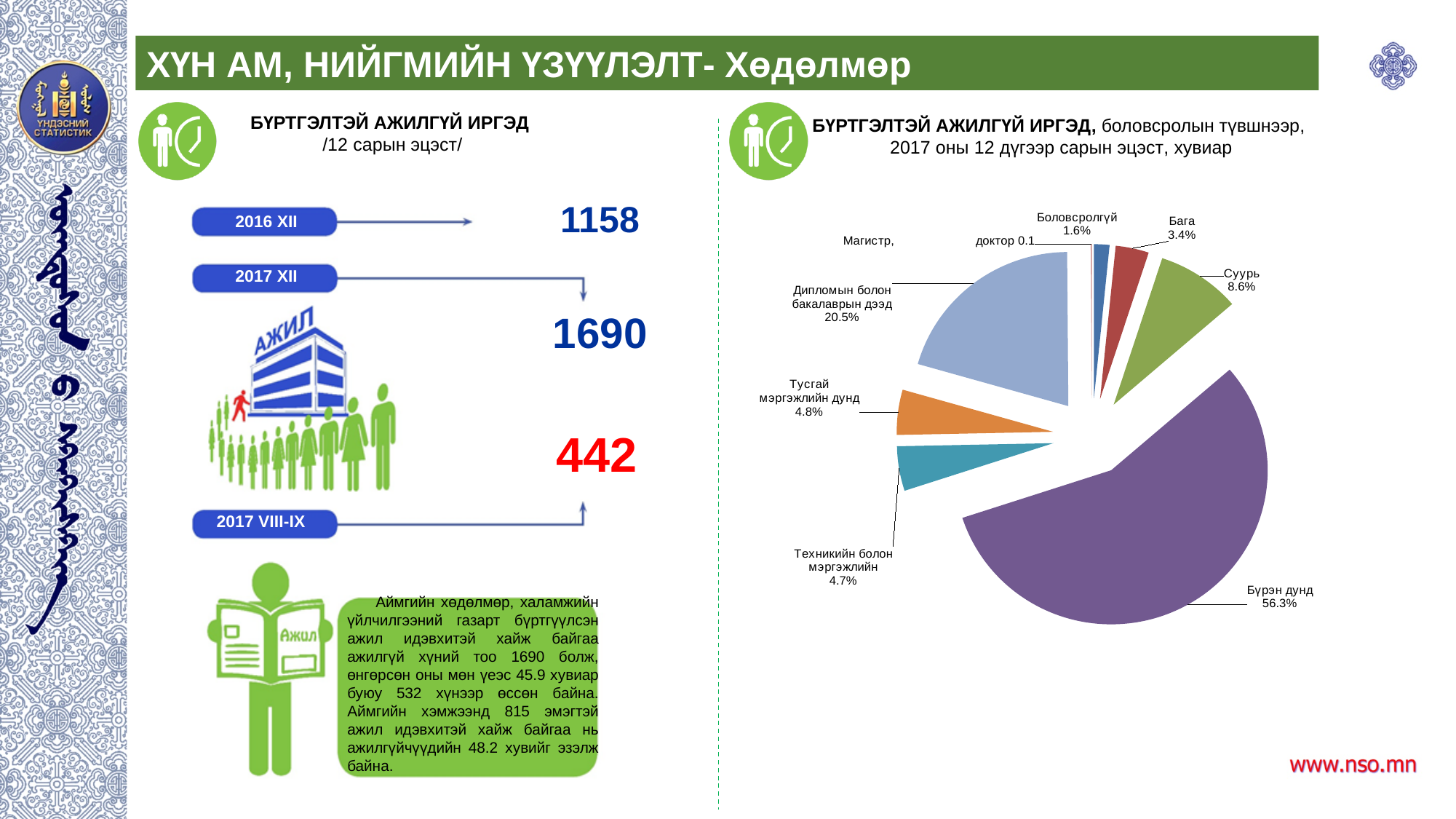
In the pie chart, what share is labelled for Дипломын болон бакалаврын дээд? 20.5% What kind of chart is shown on the right side of the slide? pie chart Which category has the largest slice in the pie chart? Бүрэн дунд In the pie chart, which is larger: the share for Суурь or the share for Бага? Суурь How many slices does the pie chart have? 8 In the pie chart, what share is labelled for Боловсролгүй? 1.6% Which category has the smallest slice in the pie chart? Магистр, доктор What colour is the Бүрэн дунд slice in the pie chart? purple In the pie chart, what is the difference between the shares for Бүрэн дунд and Дипломын болон бакалаврын дээд? 35.8% In the pie chart, what value is labelled for Магистр, доктор? 0.1 In the pie chart, what share is labelled for Бүрэн дунд? 56.3% In the pie chart, what share is labelled for Суурь? 8.6%